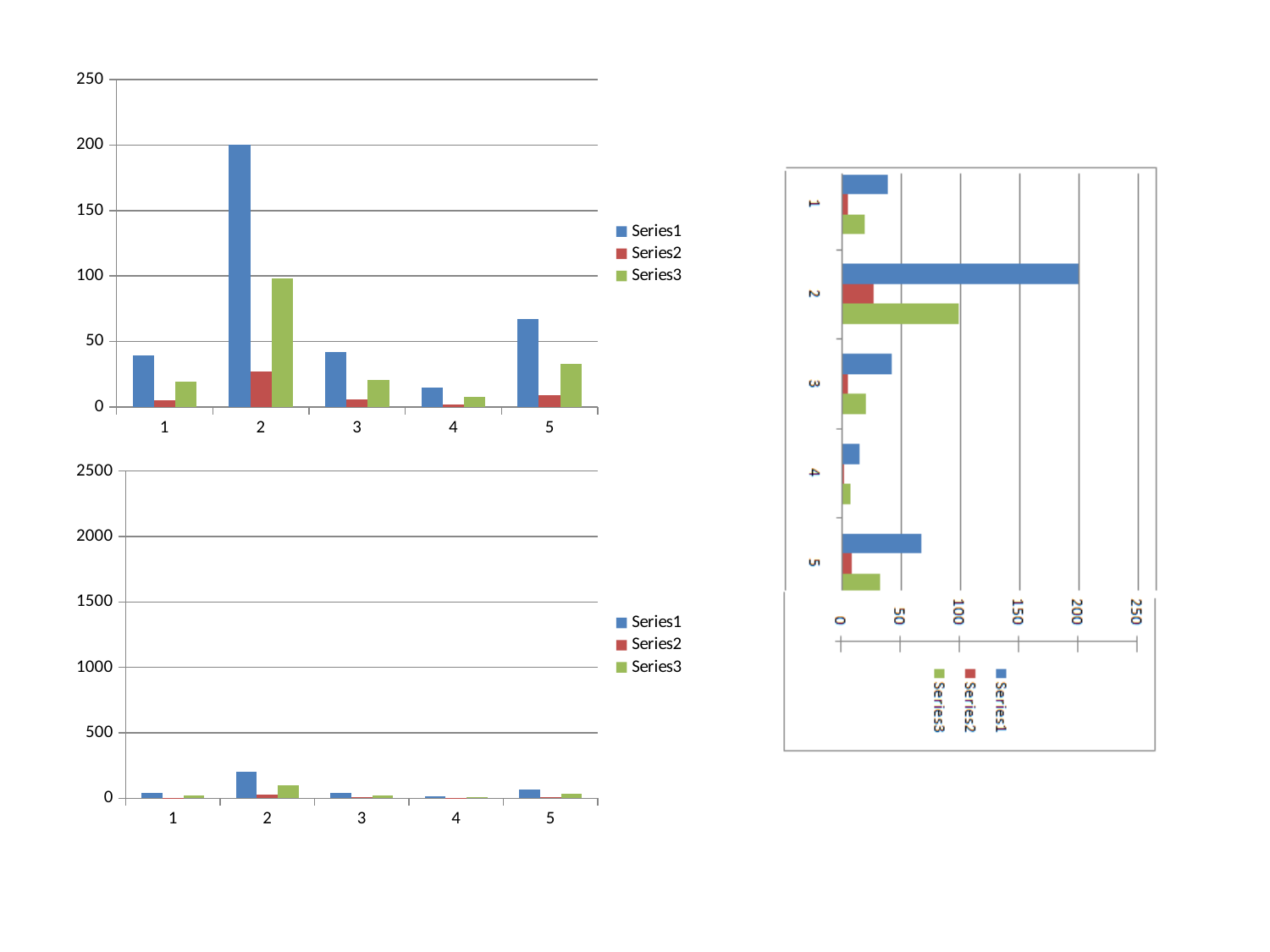
In the top-left chart, which category has the highest Series1 value? 2 In the right-hand chart, is the Series1 value for category 5 greater or less than 50? greater In the top-left chart, what is the Series1 value for category 2? 200 In the top-left chart, how many series does the legend list? 3 In the top-left chart, how many categories are shown on the x axis? 5 In the top-left chart, which category has the lowest Series1 value? 4 In the top-left chart, which is larger for category 5: Series1 or Series3? Series1 In the bottom-left chart, what is the highest value shown on the vertical axis? 2500 In the top-left chart, which colour represents Series2 in the legend? red In the right-hand chart, which category has the longest Series1 bar? 2 What kind of chart is the top-left chart? bar chart In the top-left chart, is the Series3 value for category 2 greater or less than 50? greater